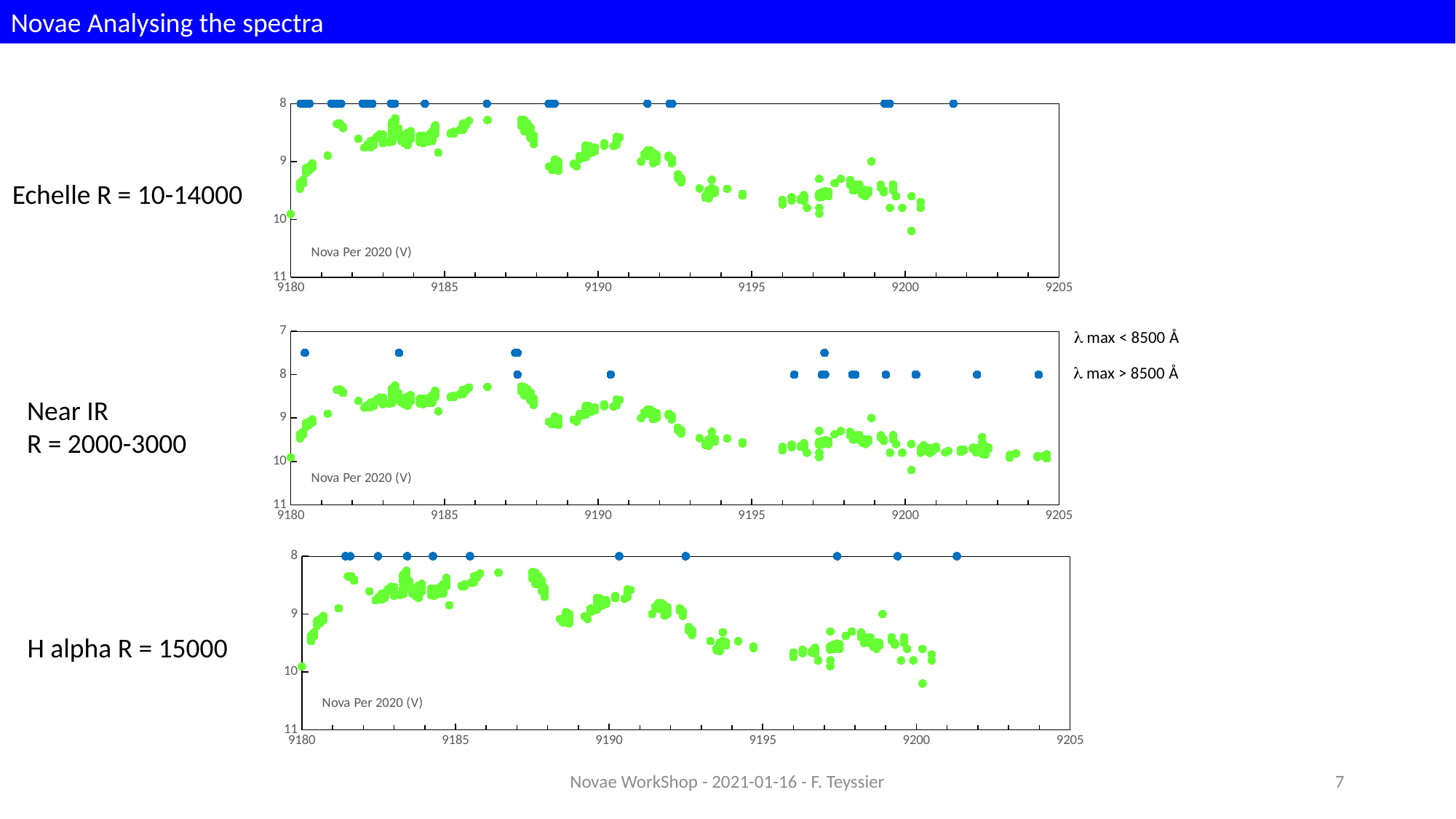
In the middle chart (Near IR R = 2000-3000), what are the two labels printed to the right of the blue point rows? λ max < 8500 Å and λ max > 8500 Å In the bottom chart (H alpha R = 15000), are the green values near x = 9199 greater or less than 9? greater In the top chart (Echelle R = 10-14000), are the green values near x = 9186 greater or less than 9? less In the top chart (Echelle R = 10-14000), what y-axis value do the blue points sit on? 8 What is the topmost y-axis tick value on the middle chart (Near IR R = 2000-3000)? 7 In the bottom chart (H alpha R = 15000), what y-axis value do the blue points sit on? 8 What is the lowest x-axis tick value shown on the charts? 9180 In the middle chart (Near IR R = 2000-3000), are the green values near x = 9204 greater or less than 9? greater What object name is printed inside each of the three charts? Nova Per 2020 (V) What is the highest x-axis tick value shown on the charts? 9205 What kind of chart is used for the three plots on the slide? scatter chart How many charts are shown on the slide? 3